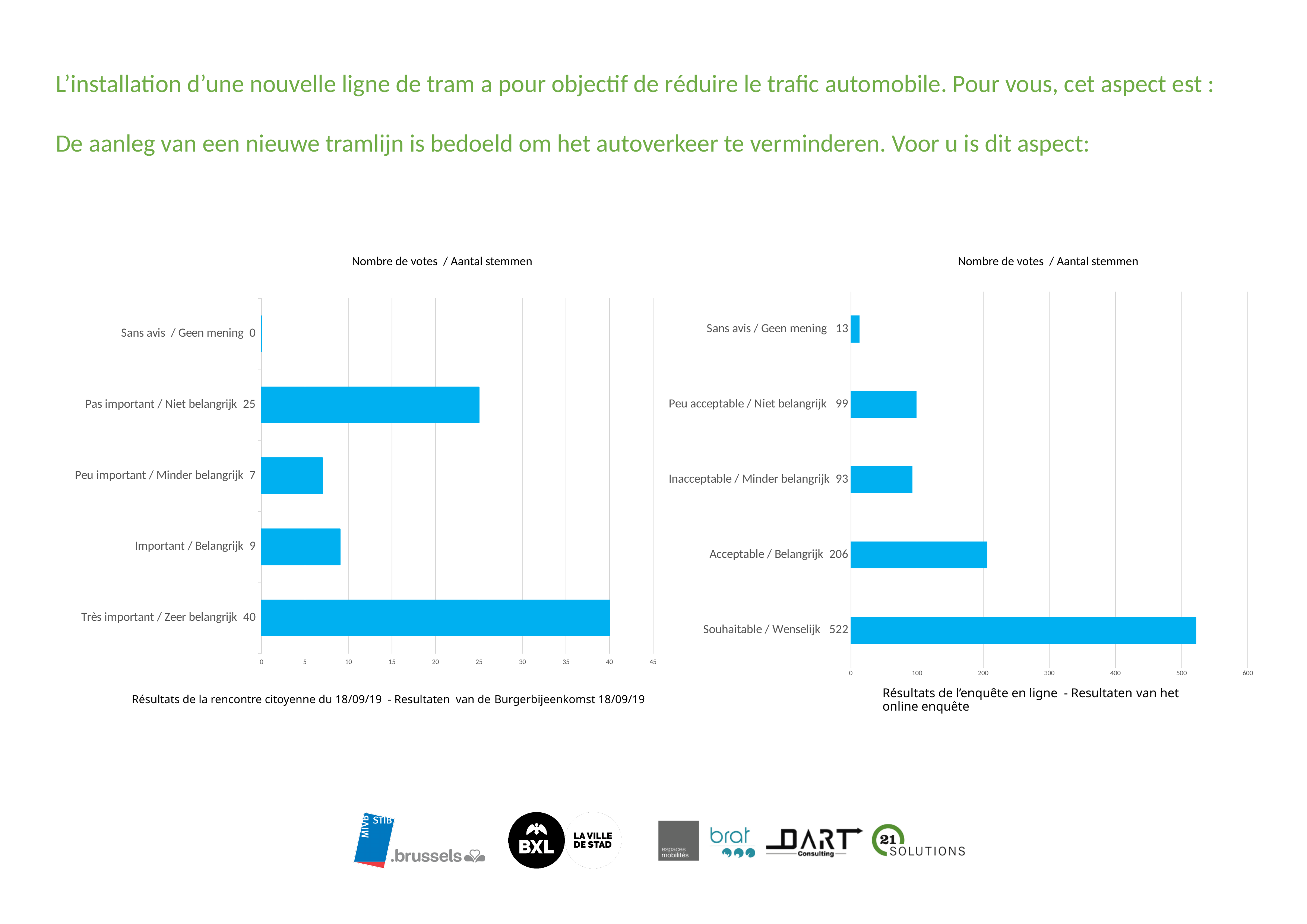
In the right chart (Résultats de l'enquête en ligne), how many votes did 'Souhaitable / Wenselijk' receive? 522 In the right chart (Résultats de l'enquête en ligne), is the value for 'Acceptable / Belangrijk' greater or less than 300? less In the right chart (Résultats de l'enquête en ligne), what is the difference in votes between 'Peu acceptable / Niet belangrijk' and 'Inacceptable / Minder belangrijk'? 6 In the left chart (Résultats de la rencontre citoyenne du 18/09/19), which received more votes: 'Important / Belangrijk' or 'Peu important / Minder belangrijk'? Important / Belangrijk In the right chart (Résultats de l'enquête en ligne), how many votes did 'Sans avis / Geen mening' receive? 13 In the left chart (Résultats de la rencontre citoyenne du 18/09/19), which category has the lowest number of votes? Sans avis / Geen mening In the left chart (Résultats de la rencontre citoyenne du 18/09/19), what is the difference in votes between 'Très important / Zeer belangrijk' and 'Pas important / Niet belangrijk'? 15 How many categories are shown in the right chart (Résultats de l'enquête en ligne)? 5 In the right chart (Résultats de l'enquête en ligne), which category has the highest number of votes? Souhaitable / Wenselijk In the left chart (Résultats de la rencontre citoyenne du 18/09/19), how many votes did 'Pas important / Niet belangrijk' receive? 25 In the left chart (Résultats de la rencontre citoyenne du 18/09/19), how many votes did 'Très important / Zeer belangrijk' receive? 40 What type of chart is the left chart (Résultats de la rencontre citoyenne du 18/09/19)? Bar chart